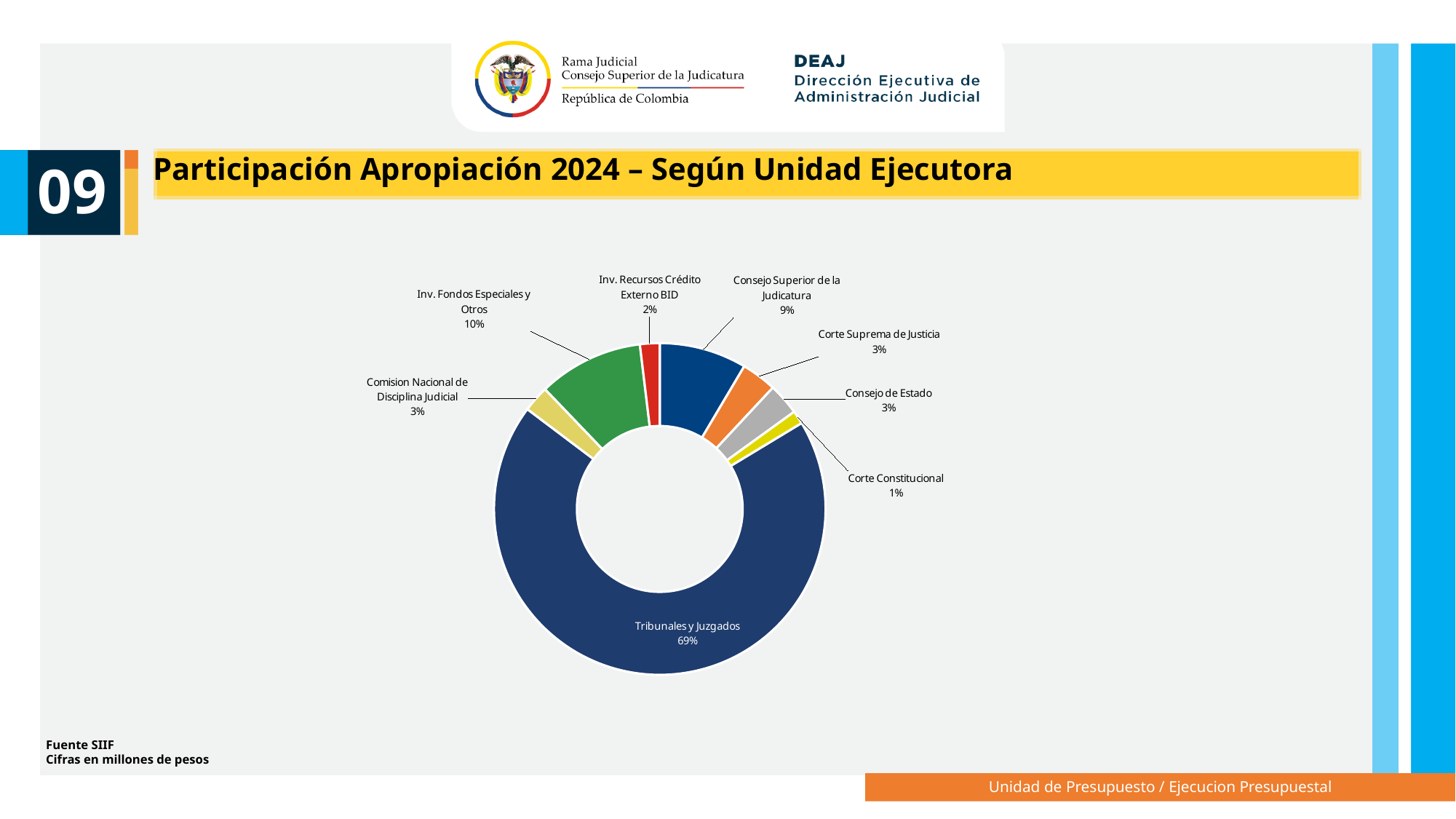
What share does Consejo Superior de la Judicatura have? 9% What share does Inv. Recursos Crédito Externo BID have? 2% Which has a larger share, Inv. Fondos Especiales y Otros or Consejo Superior de la Judicatura? Inv. Fondos Especiales y Otros Which category has the largest share of the chart? Tribunales y Juzgados What share does Corte Constitucional have? 1% What is the difference in percentage points between Tribunales y Juzgados and Inv. Fondos Especiales y Otros? 59 What share does Tribunales y Juzgados have in the chart? 69% How many categories are shown in the chart? 8 Which category has the smallest share of the chart? Corte Constitucional What kind of chart is shown on the slide? Doughnut (pie) chart What is the title of the slide containing the chart? Participación Apropiación 2024 – Según Unidad Ejecutora What share does Inv. Fondos Especiales y Otros have? 10%